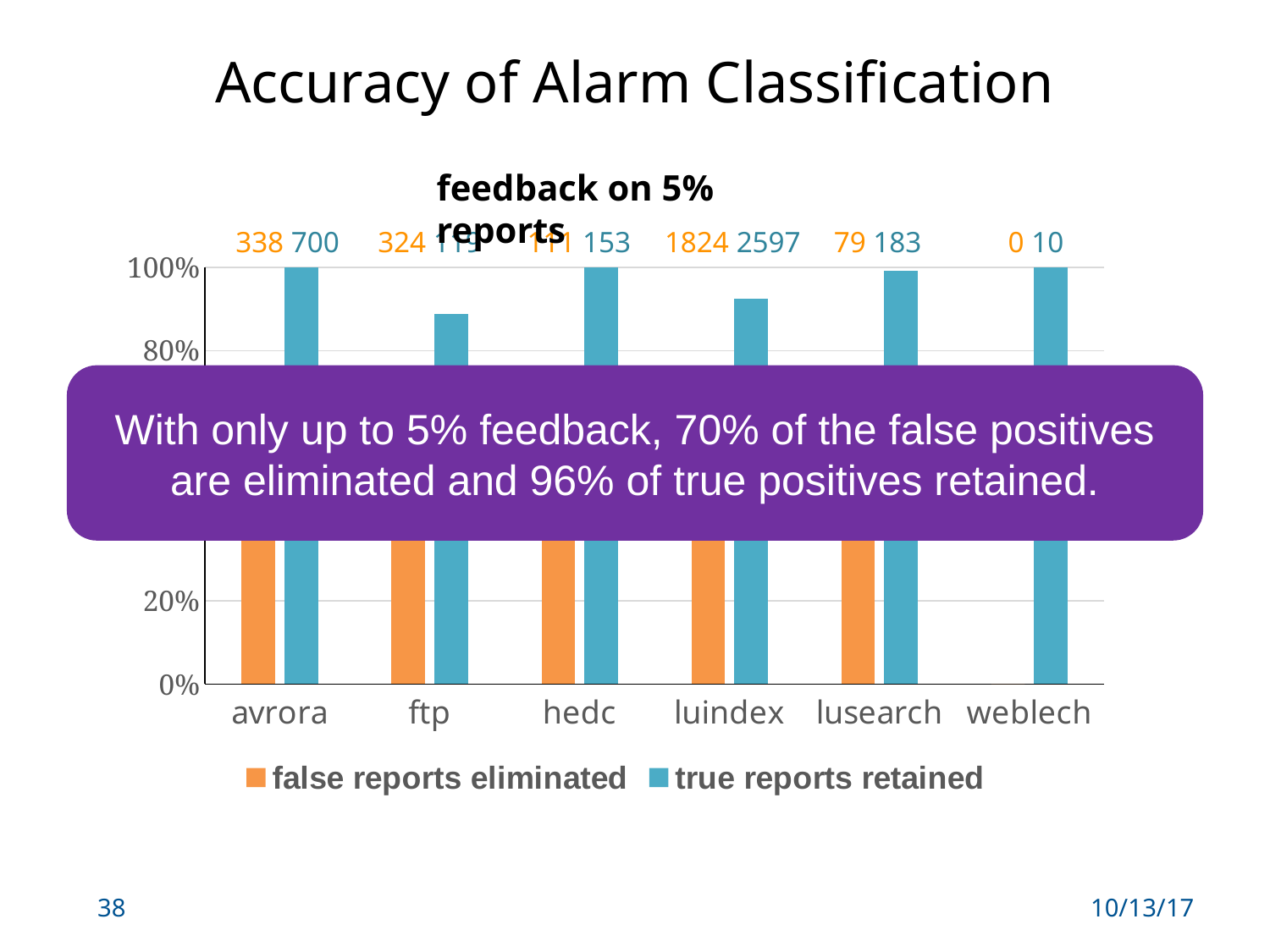
Is the 'true reports retained' value for ftp greater or less than 80%? greater Is the 'false reports eliminated' value for avrora greater or less than 20%? greater How many series does the chart legend list? 2 How many categories are shown along the x axis of the chart? 6 Is the 'true reports retained' value for luindex greater or less than 100%? less What numbers are printed above the bars for luindex? 1824 2597 What are the two series named in the chart legend? false reports eliminated, true reports retained Which has a higher 'true reports retained' value, avrora or ftp? avrora Which category has the lowest 'true reports retained' bar? ftp What colour are the bars for the 'true reports retained' series? blue What kind of chart is shown on the slide? bar chart What numbers are printed above the bars for weblech? 0 10